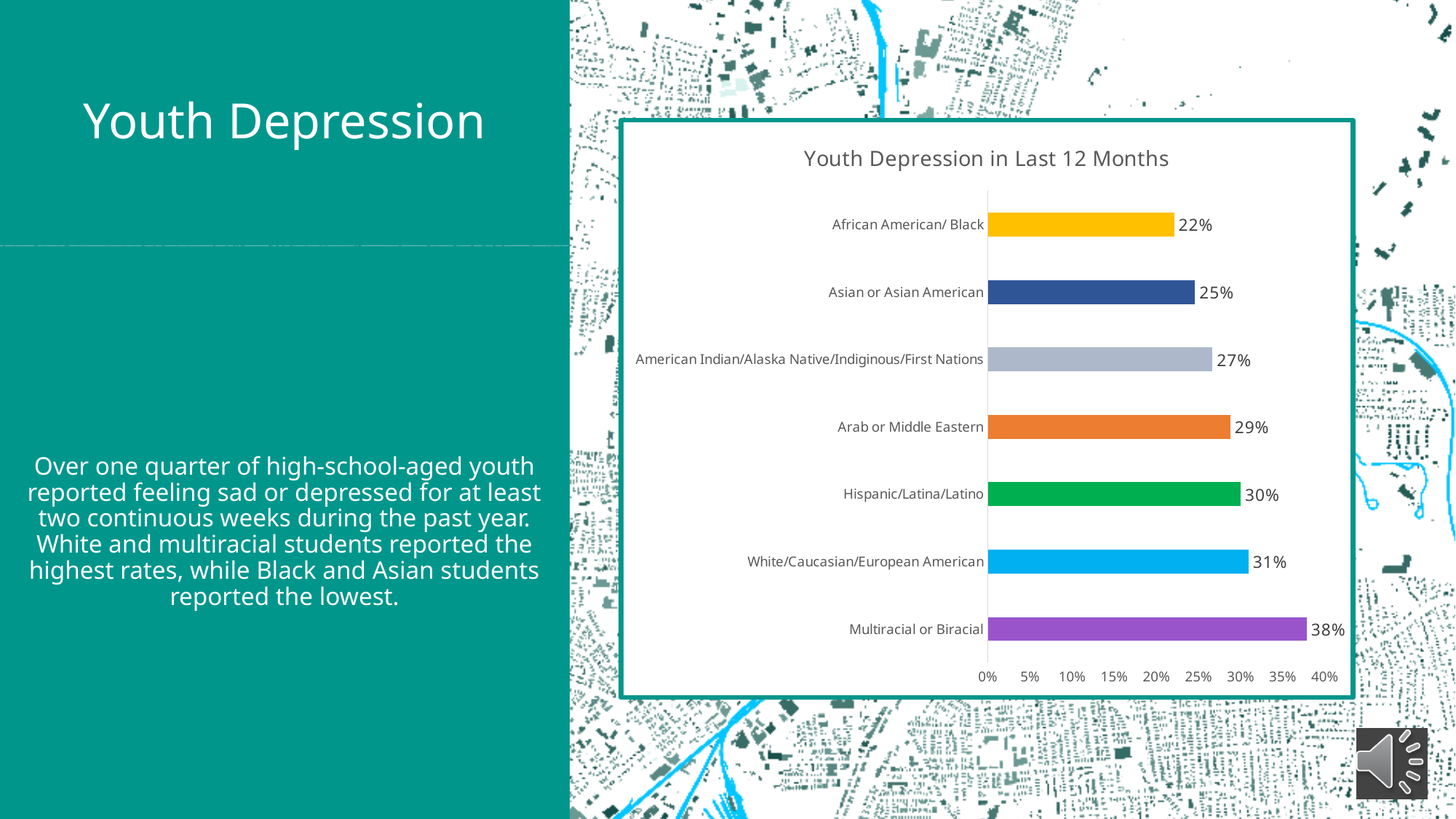
What kind of chart is shown on the slide? Bar chart What is the value for Asian or Asian American? 25% Which category has the lowest value? African American/ Black Which category has the highest value? Multiracial or Biracial Is the value for American Indian/Alaska Native/Indiginous/First Nations greater or less than 25%? greater What is the value for Arab or Middle Eastern? 29% How many categories are shown in the chart? 7 What is the difference between the values for Multiracial or Biracial and African American/ Black? 16% Which is larger, the value for Arab or Middle Eastern or the value for Asian or Asian American? Arab or Middle Eastern What is the title of the chart? Youth Depression in Last 12 Months What is the value for Multiracial or Biracial in the Youth Depression in Last 12 Months chart? 38% What is the difference between the values for White/Caucasian/European American and Hispanic/Latina/Latino? 1%